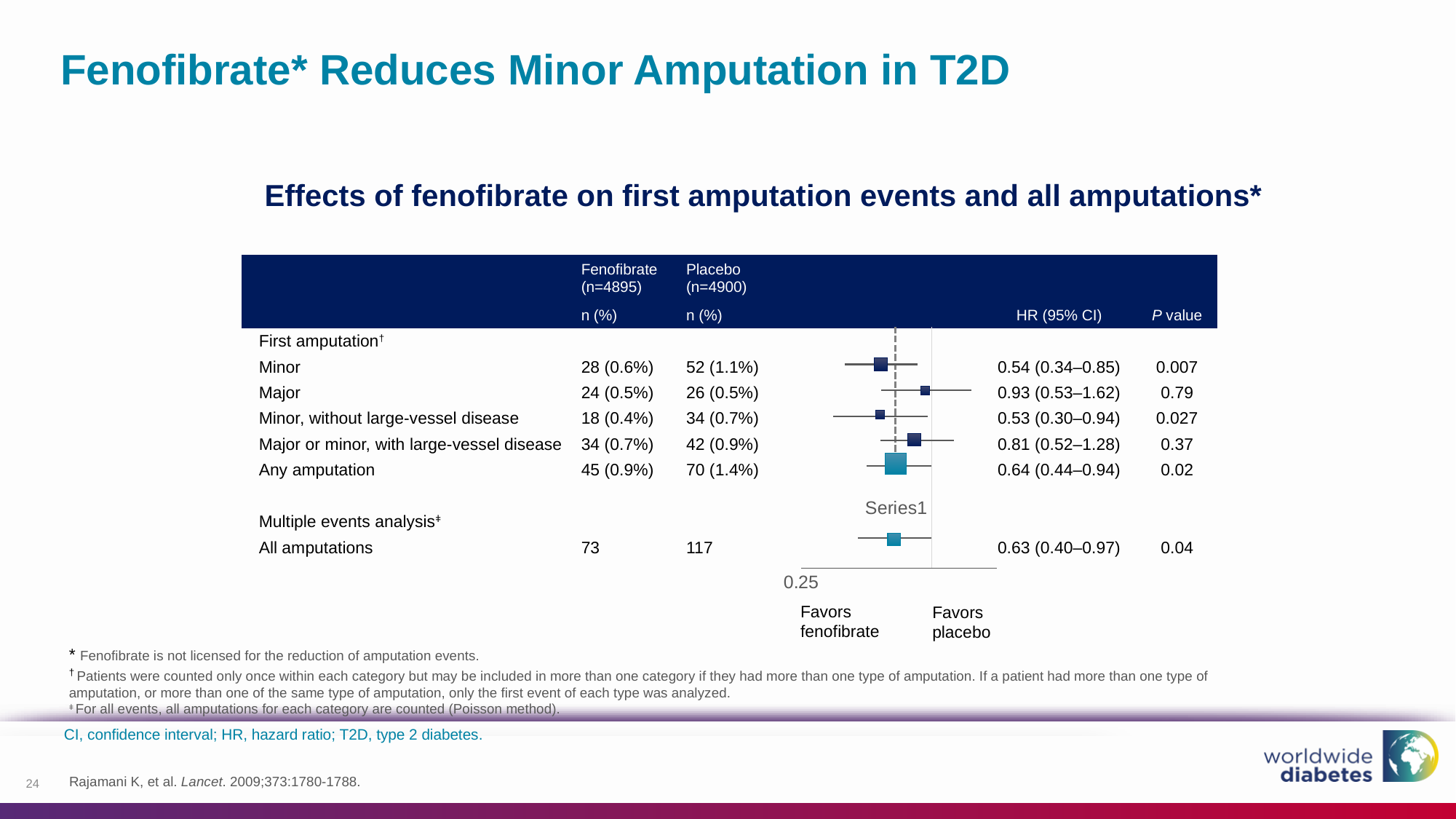
How many hazard ratio points are plotted in the forest plot? 6 What series name is displayed in the forest plot? Series1 What kind of chart is shown in the middle of the table on this slide? Forest plot How many patients in the placebo group had any amputation? 70 (1.4%) Which amputation category has the highest hazard ratio? Major Which amputation category has the lowest hazard ratio? Minor, without large-vessel disease What is the difference between the hazard ratios for Major and Minor first amputation? 0.39 What is the P value for major first amputation? 0.79 What is the hazard ratio (95% CI) for minor first amputation? 0.54 (0.34–0.85) What is the hazard ratio (95% CI) for all amputations in the multiple events analysis? 0.63 (0.40–0.97) What is the only numeric tick label shown on the x axis of the forest plot? 0.25 Which has the larger hazard ratio: Major or Minor first amputation? Major